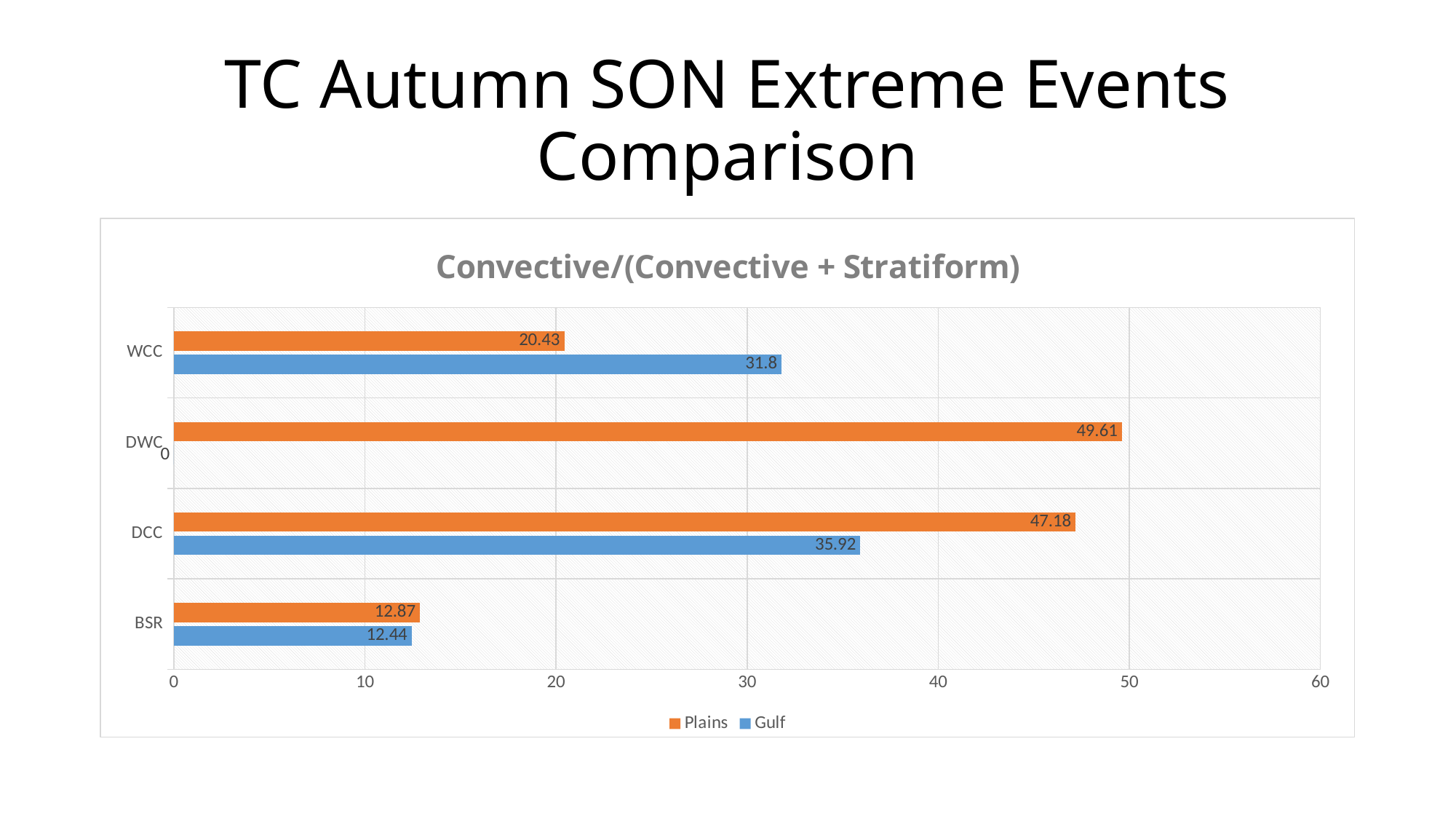
Which category has the highest Plains value? DWC What is the title of the chart? Convective/(Convective + Stratiform) Is the Plains value for BSR greater or less than 10? greater How many categories are shown on the y axis? 4 What is the Gulf value for DWC? 0 Which category has the lowest Gulf value? DWC For WCC, which series has the larger value, Plains or Gulf? Gulf What is the difference between the Plains and Gulf values for DCC? 11.26 What is the Gulf value for DCC? 35.92 What kind of chart is shown? bar chart What is the Plains value for WCC? 20.43 How many series does the legend list? 2